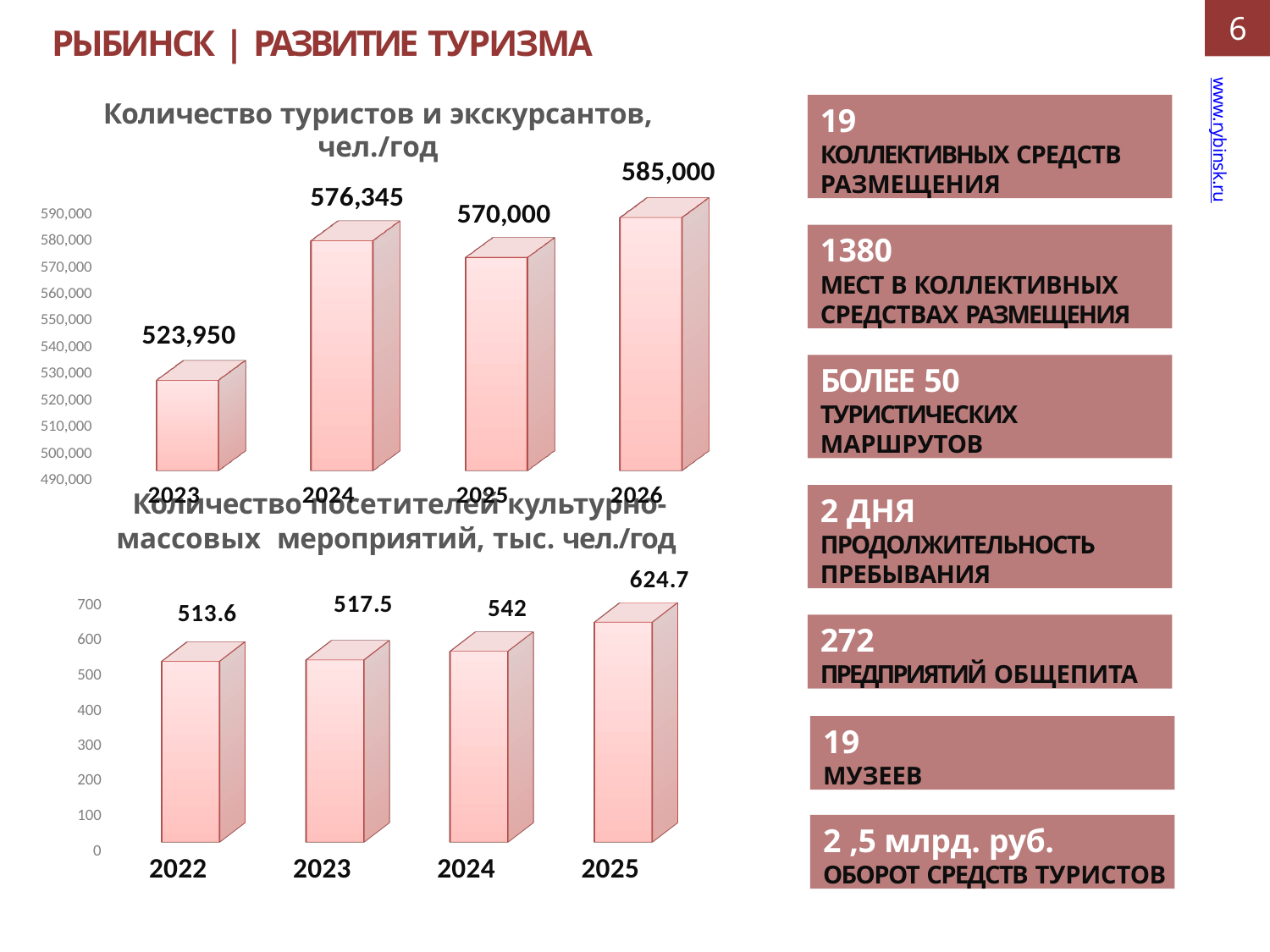
In the top chart (Количество туристов и экскурсантов, чел./год), which year has the highest value? 2026 In the top chart (Количество туристов и экскурсантов, чел./год), what is the difference between the 2026 and 2023 values? 61,050 In the top chart (Количество туристов и экскурсантов, чел./год), what is the value for 2023? 523,950 In the top chart (Количество туристов и экскурсантов, чел./год), which year has the lowest value? 2023 In the bottom chart (Количество посетителей культурно-массовых мероприятий, тыс. чел./год), do the values rise or fall from 2022 to 2025? rise How many years are shown in the top chart (Количество туристов и экскурсантов, чел./год)? 4 What kind of chart is the bottom chart (Количество посетителей культурно-массовых мероприятий, тыс. чел./год)? bar chart In the bottom chart (Количество посетителей культурно-массовых мероприятий, тыс. чел./год), what is the value for 2025? 624.7 In the top chart (Количество туристов и экскурсантов, чел./год), what is the value for 2025? 570,000 In the bottom chart (Количество посетителей культурно-массовых мероприятий, тыс. чел./год), what is the difference between the 2024 and 2023 values? 24.5 In the bottom chart (Количество посетителей культурно-массовых мероприятий, тыс. чел./год), what is the value for 2022? 513.6 In the top chart (Количество туристов и экскурсантов, чел./год), which is larger, the value for 2024 or for 2025? 2024